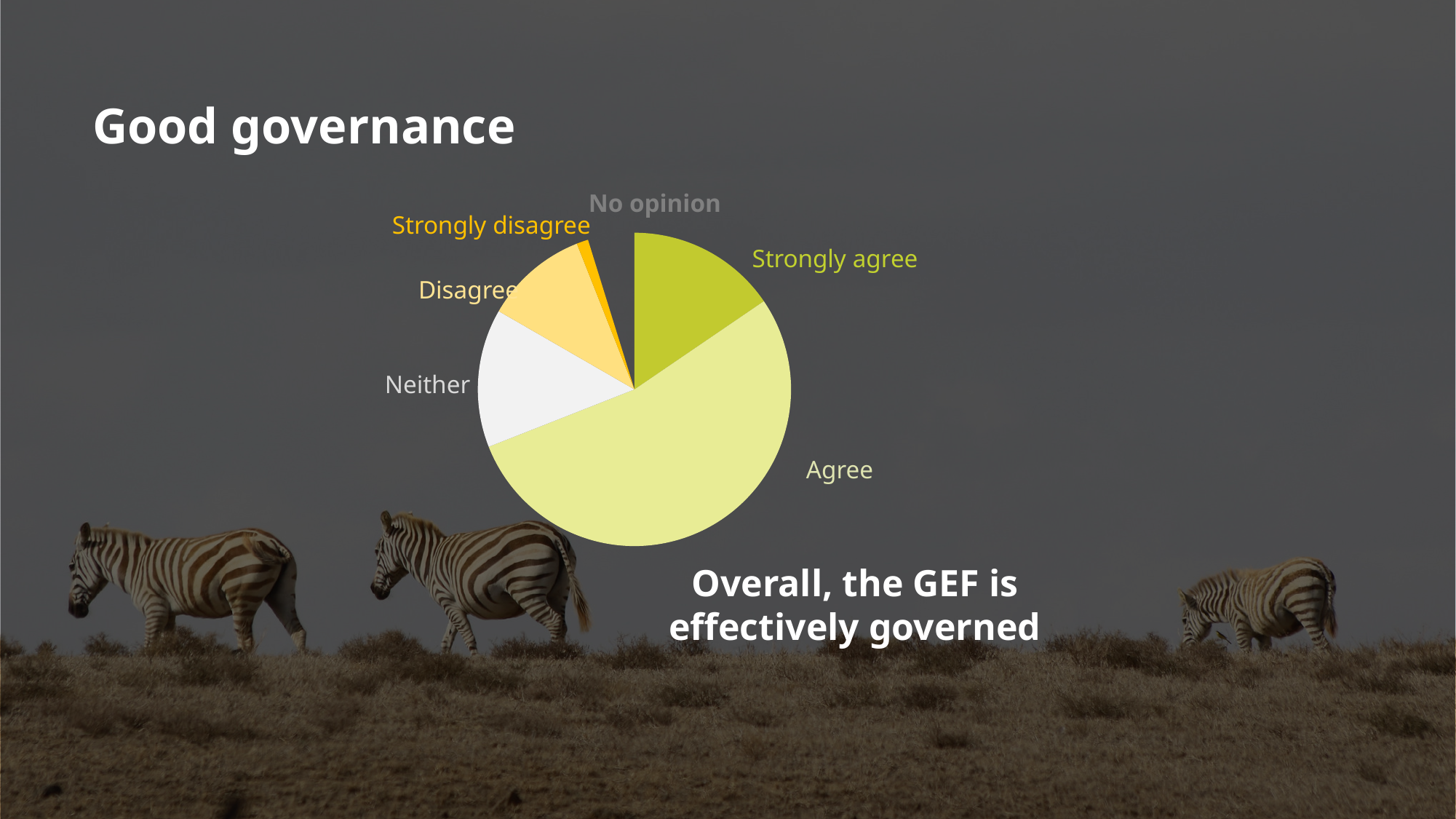
How many slices does the pie chart have? 6 Which slice is larger, Strongly agree or Strongly disagree? Strongly agree What kind of chart is shown on the slide? Pie chart What statement does the pie chart show responses to? Overall, the GEF is effectively governed Which slice is larger, Neither or Disagree? Neither Which slice is larger, Agree or Strongly agree? Agree Which response category has the largest slice of the pie chart? Agree What is the title of the slide? Good governance